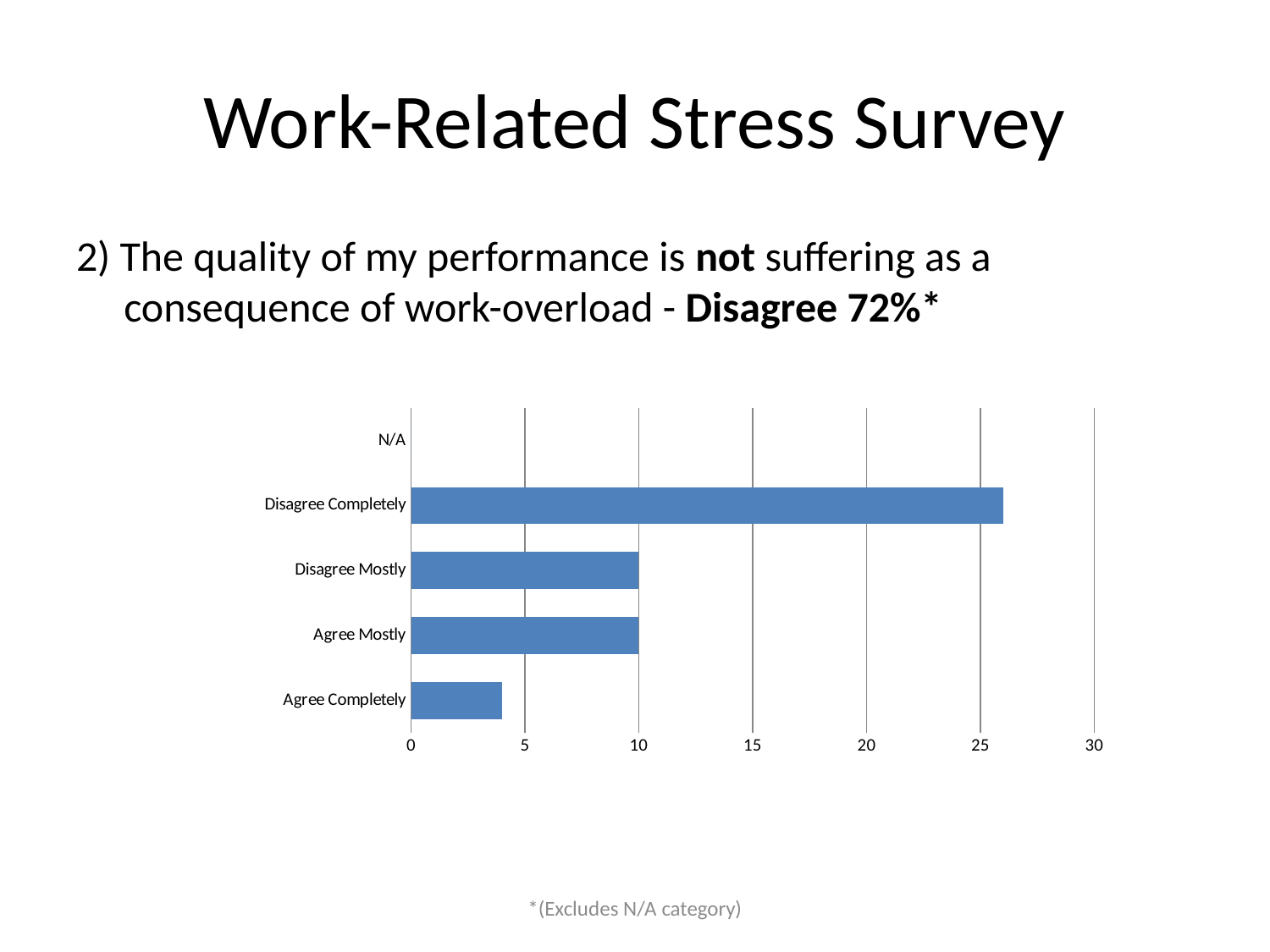
Which category has the longest bar in the chart? Disagree Completely What is the value for Disagree Mostly? 10 Which category has the shortest visible bar in the chart? Agree Completely Which is larger, the value for Disagree Mostly or the value for Agree Completely? Disagree Mostly What kind of chart is shown on the slide? Bar chart Which category on the chart has no visible bar? N/A How many categories are listed on the vertical axis of the chart? 5 Is the value for Disagree Completely greater or less than 30? less Is the value for Disagree Completely greater or less than 25? greater Which is larger, the value for Disagree Completely or the value for Agree Completely? Disagree Completely Is the value for Agree Completely greater or less than 5? less What is the value for Agree Mostly? 10